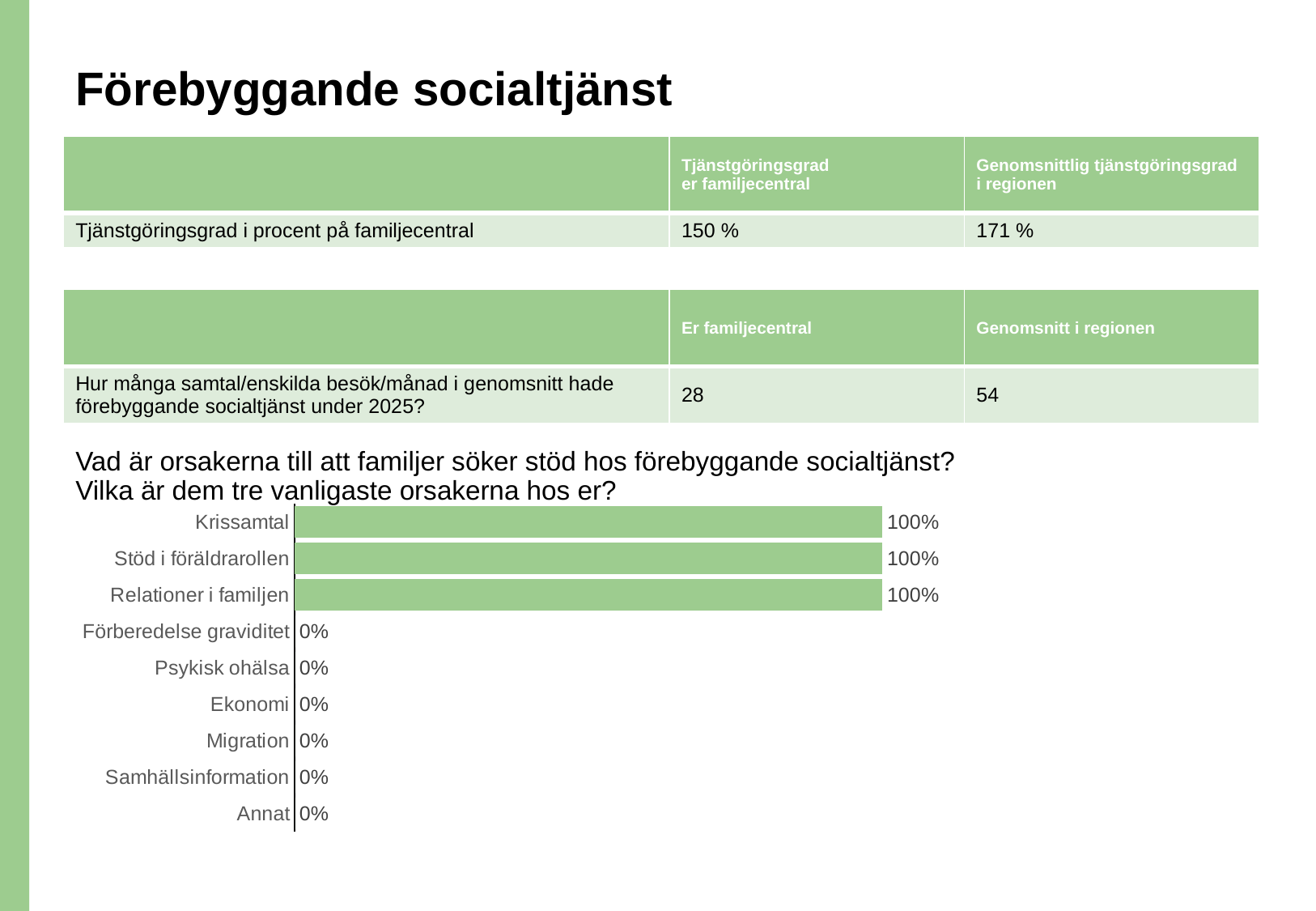
Which category is listed first (at the top) in the bar chart? Krissamtal What value does the bar chart show for Krissamtal? 100% What value does the bar chart show for Psykisk ohälsa? 0% How many categories in the bar chart have a value of 100%? 3 What is the difference between the value for Relationer i familjen and the value for Samhällsinformation in the bar chart? 100% How many categories are shown in the bar chart? 9 What value does the bar chart show for Ekonomi? 0% Which is larger in the bar chart, the value for Krissamtal or the value for Migration? Krissamtal What value does the bar chart show for Stöd i föräldrarollen? 100% What kind of chart is shown on the slide? bar chart What value does the bar chart show for Annat? 0% What value does the bar chart show for Relationer i familjen? 100%